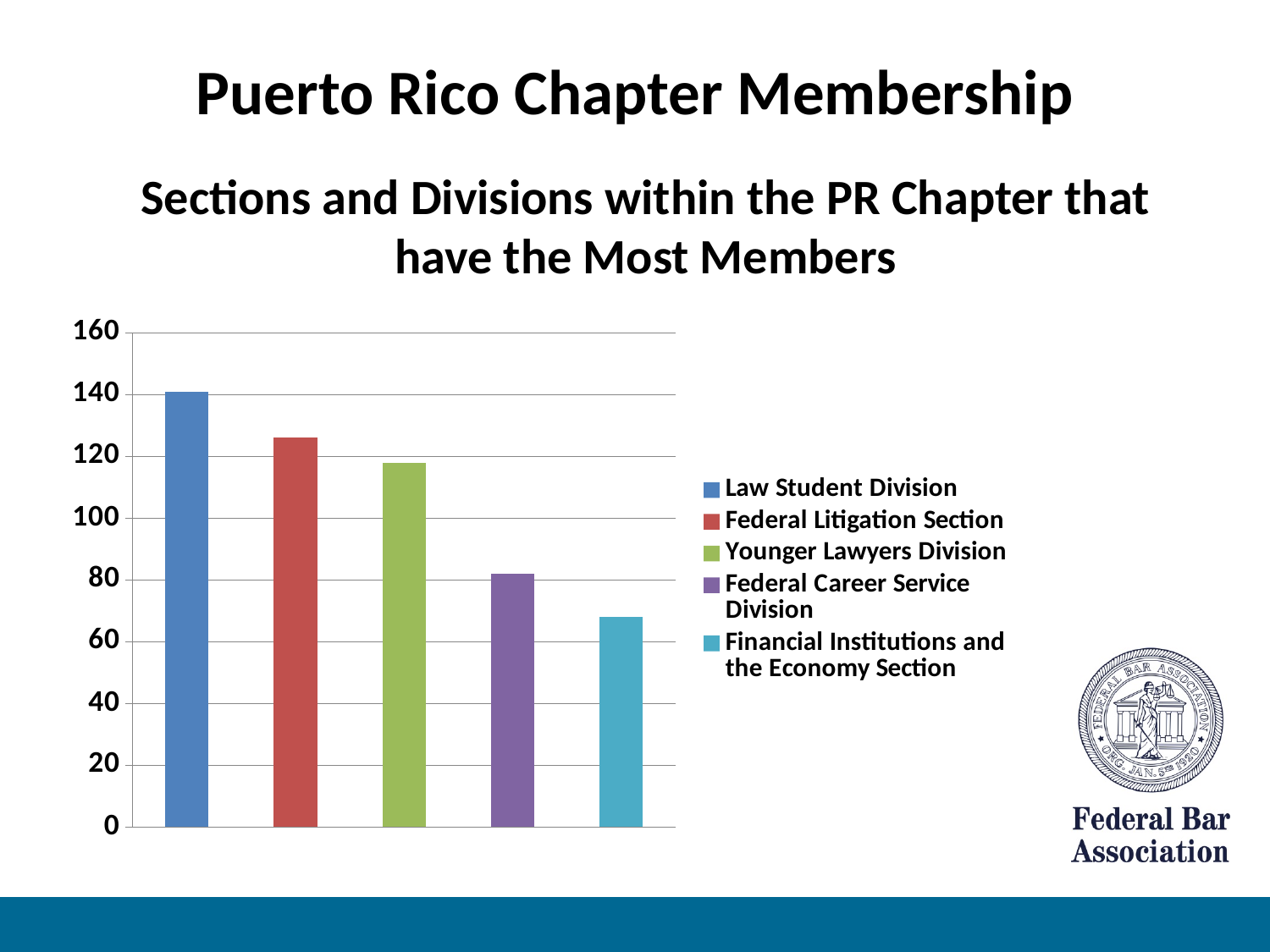
Is the value for Financial Institutions and the Economy Section greater or less than 80? less Which has more members, Federal Litigation Section or Federal Career Service Division? Federal Litigation Section What kind of chart is shown on the slide? bar chart Do the bar values rise or fall from left to right across the chart? fall Which section or division has the highest number of members? Law Student Division How many entries does the legend list? 5 Which section or division has the lowest number of members? Financial Institutions and the Economy Section Is the value for Federal Litigation Section greater or less than 120? greater How many sections or divisions are plotted in the chart? 5